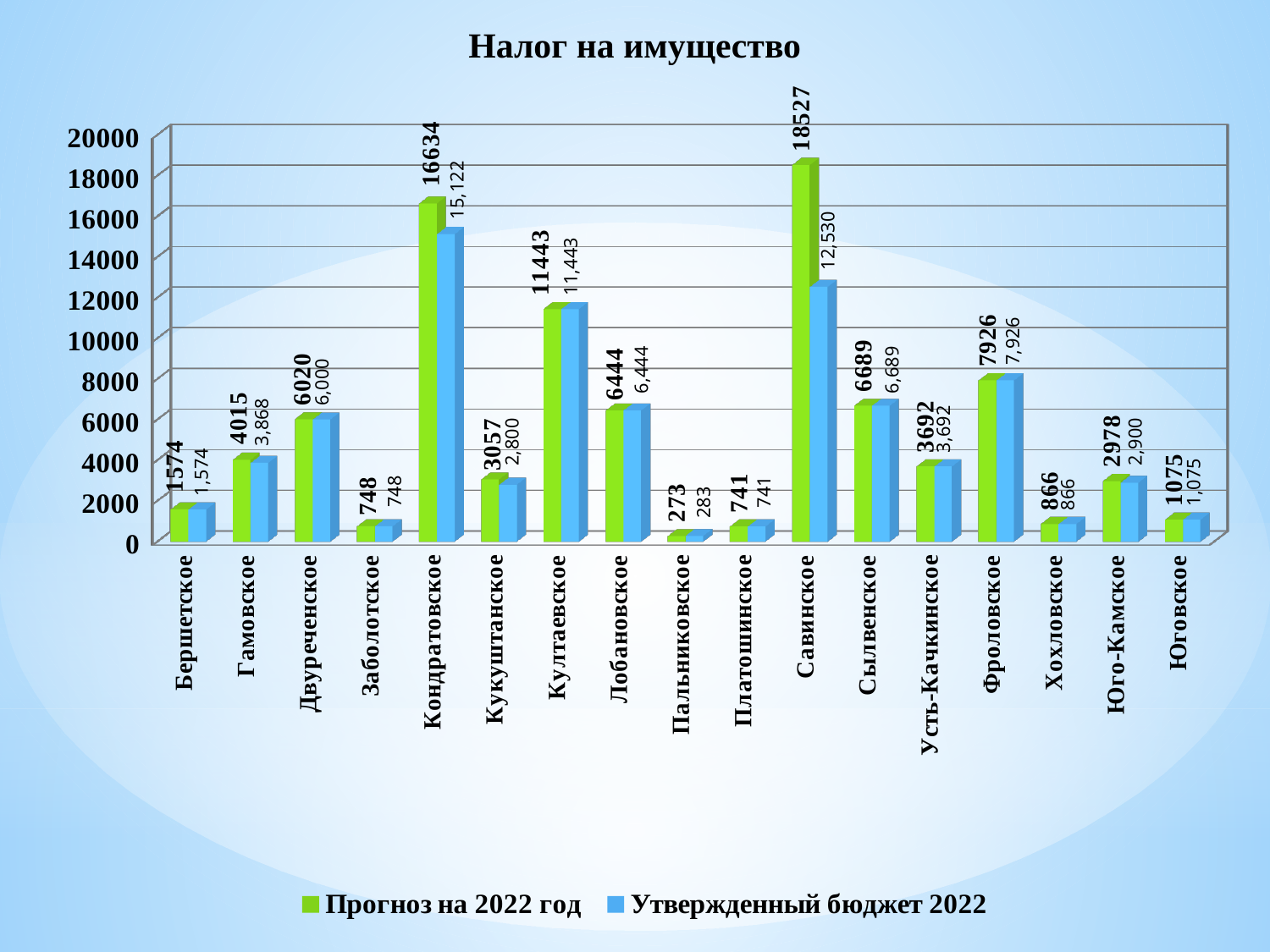
What is the difference between "Прогноз на 2022 год" and "Утвержденный бюджет 2022" for Савинское? 5997 What is the value of "Прогноз на 2022 год" for Савинское? 18527 What is the value of "Утвержденный бюджет 2022" for Пальниковское? 283 What is the value of "Утвержденный бюджет 2022" for Кондратовское? 15,122 Which is larger for Гамовское: "Прогноз на 2022 год" or "Утвержденный бюджет 2022"? Прогноз на 2022 год How many categories are shown on the x axis? 17 Is the value of "Утвержденный бюджет 2022" for Кондратовское greater or less than 14000? greater Which category has the lowest value for "Прогноз на 2022 год"? Пальниковское How many series does the legend list? 2 What is the value of "Прогноз на 2022 год" for Кукуштанское? 3057 Which category has the highest value for "Прогноз на 2022 год"? Савинское What type of chart is shown on the slide? Bar chart